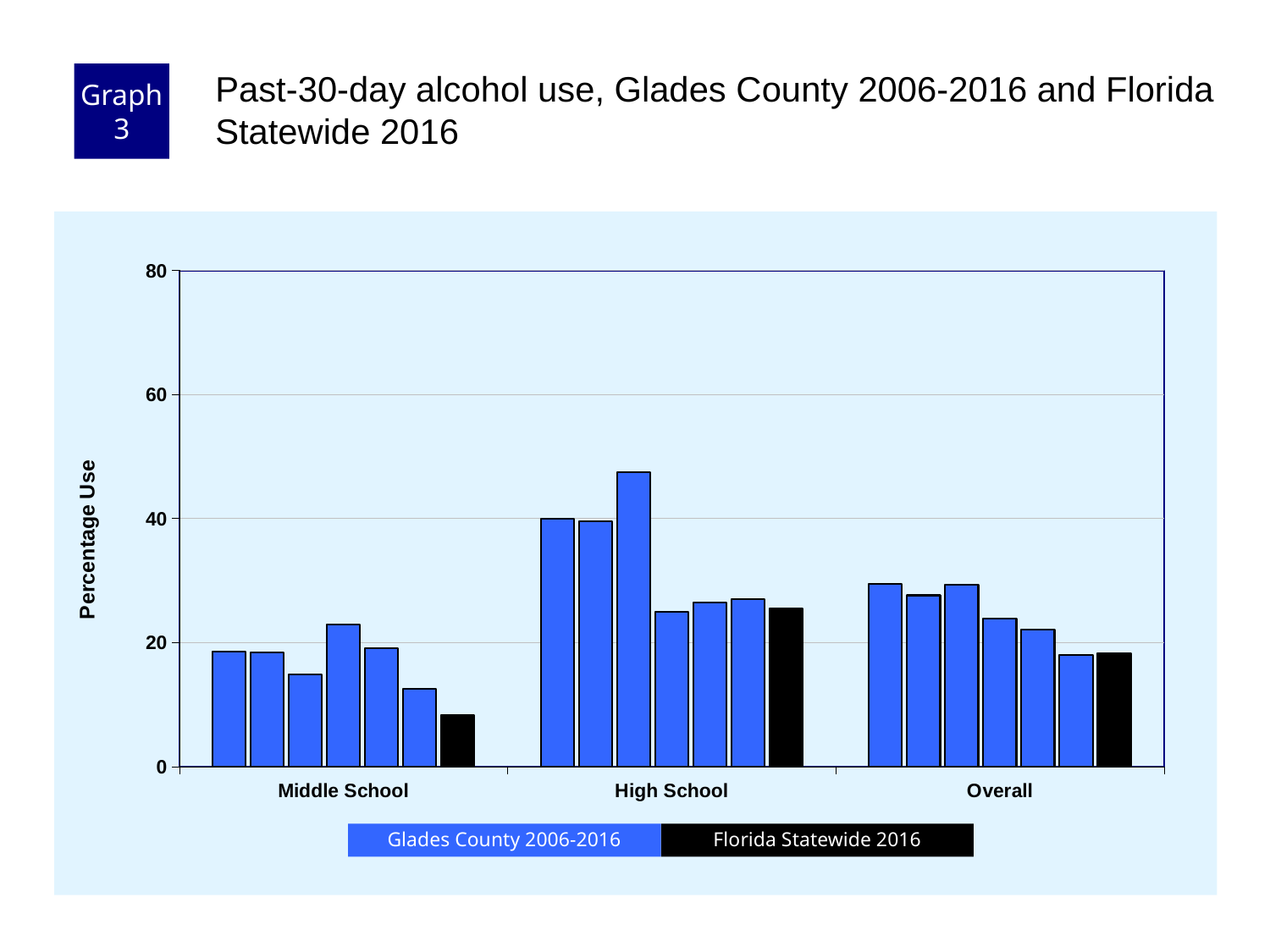
How many categories are shown on the x axis? 3 Is the Florida Statewide 2016 value for Middle School greater or less than 20? less What kind of chart is shown on the slide? bar chart Is the tallest Glades County 2006-2016 bar for High School greater or less than 40? greater Is the Florida Statewide 2016 value for High School greater or less than 20? greater Which category has the highest Florida Statewide 2016 value? High School Which category has the lowest Florida Statewide 2016 value? Middle School Which is larger: the Florida Statewide 2016 value for High School or for Middle School? High School What is the title of the y axis? Percentage Use What colour are the Florida Statewide 2016 bars? black How many series does the legend list? 2